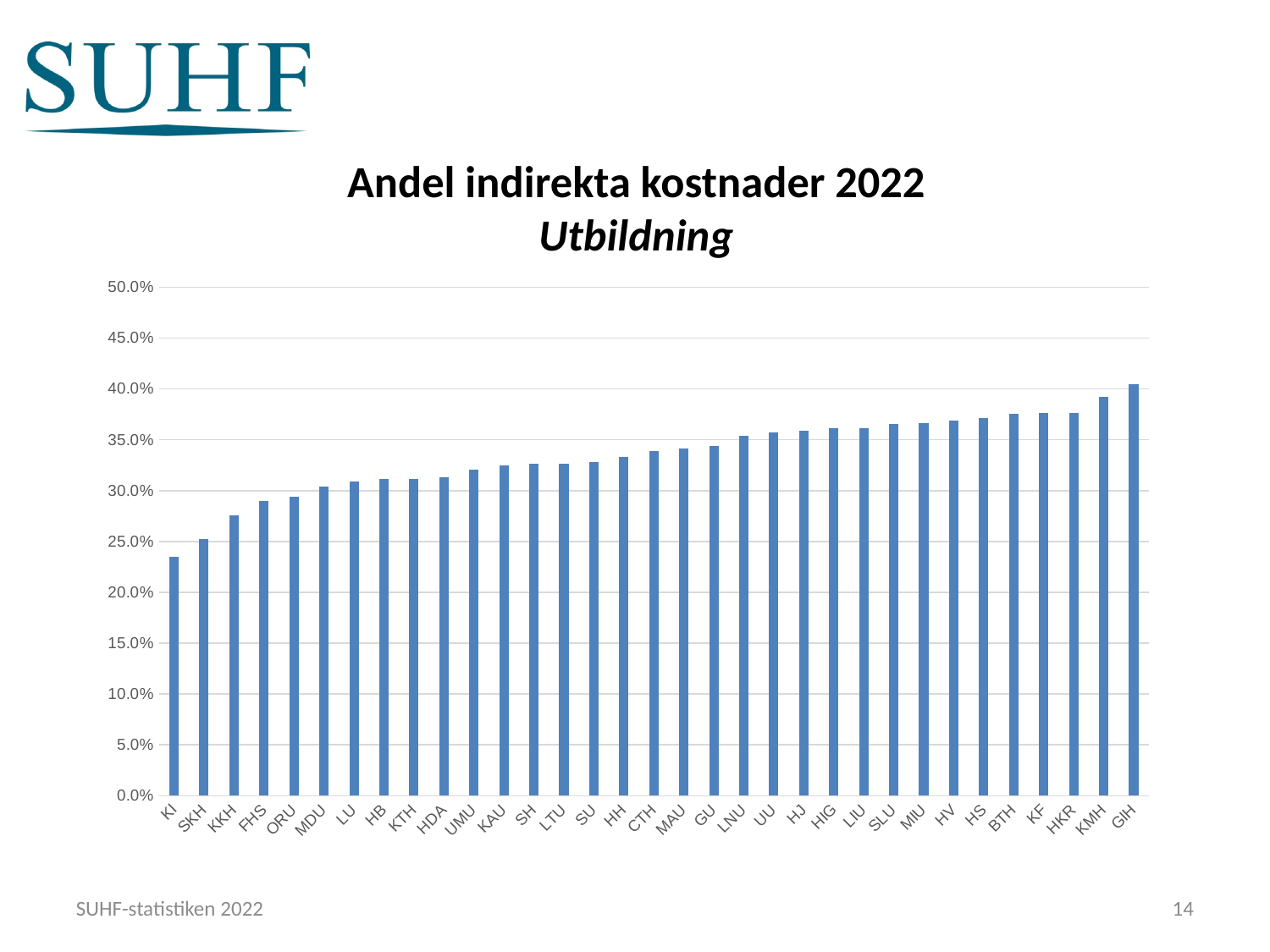
What is the title of the chart? Andel indirekta kostnader 2022 Utbildning Which category has the lowest value in the chart? KI Is the value for KI greater or less than 25.0%? less Is the value for GIH greater or less than 40.0%? greater Do the values generally rise or fall from left to right along the x axis? rise How many categories (bars) are plotted in the chart? 33 Is the value for KKH greater or less than 30.0%? less Which category has the highest value in the chart? GIH Which has the larger value, FHS or HS? HS Which has the larger value, SKH or KMH? KMH What kind of chart is shown on the slide? bar chart